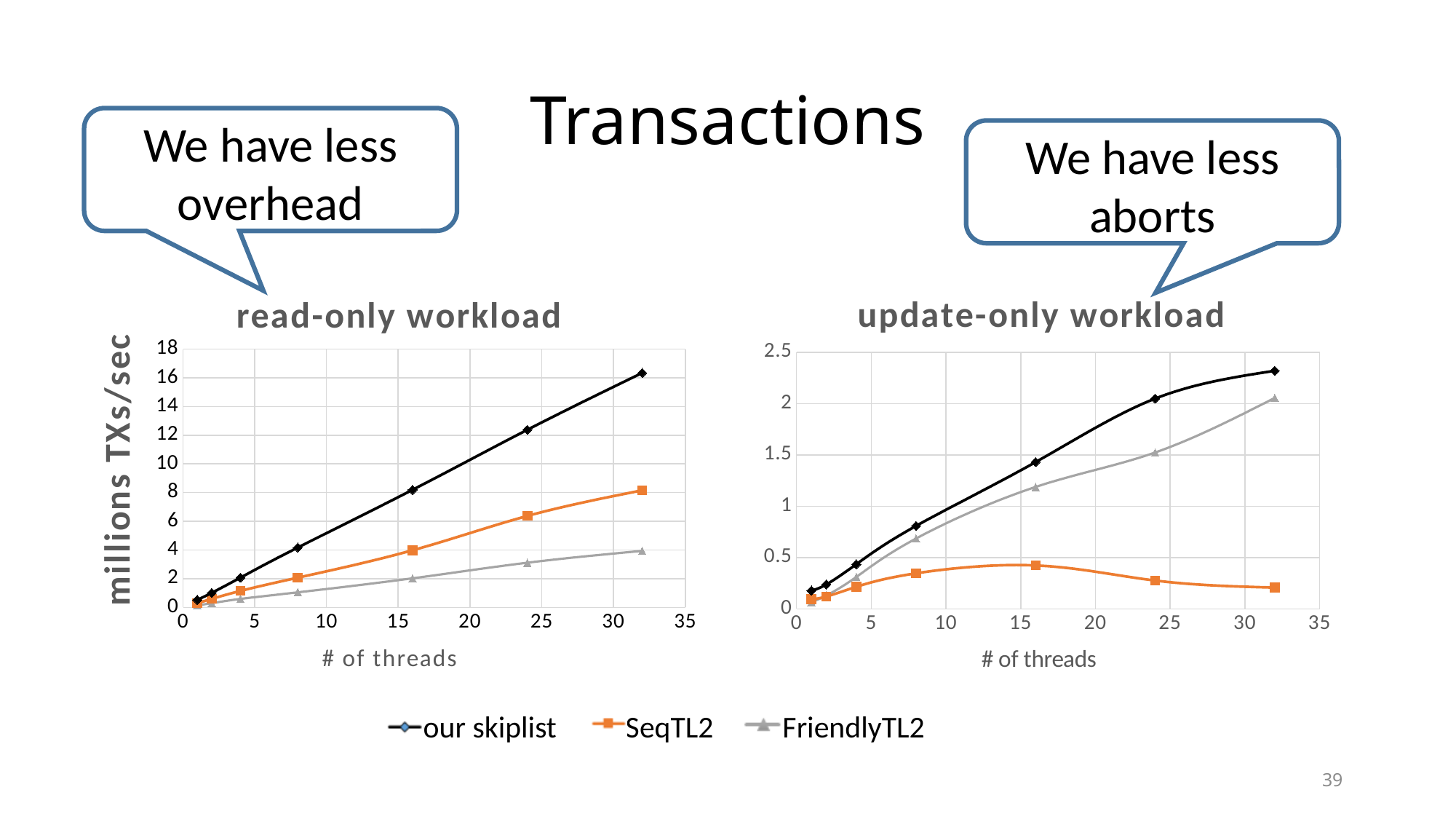
How many series does the legend list? 3 In the update-only workload chart, is the value for our skiplist at 32 threads greater or less than 2? greater In the read-only workload chart, is the value for FriendlyTL2 at 32 threads greater or less than 6? less In the read-only workload chart, is the value for our skiplist at 32 threads greater or less than 14? greater In the read-only workload chart, which series has the lowest value at 32 threads? FriendlyTL2 In the update-only workload chart, which series has the lowest value at 32 threads? SeqTL2 In the update-only workload chart, which is larger at 24 threads: our skiplist or FriendlyTL2? our skiplist What kind of chart is the read-only workload chart? line chart What is the y-axis label of the read-only workload chart? millions TXs/sec In the read-only workload chart, which series has the highest value at 32 threads? our skiplist In the read-only workload chart, does the value for our skiplist rise or fall as the number of threads increases? rise